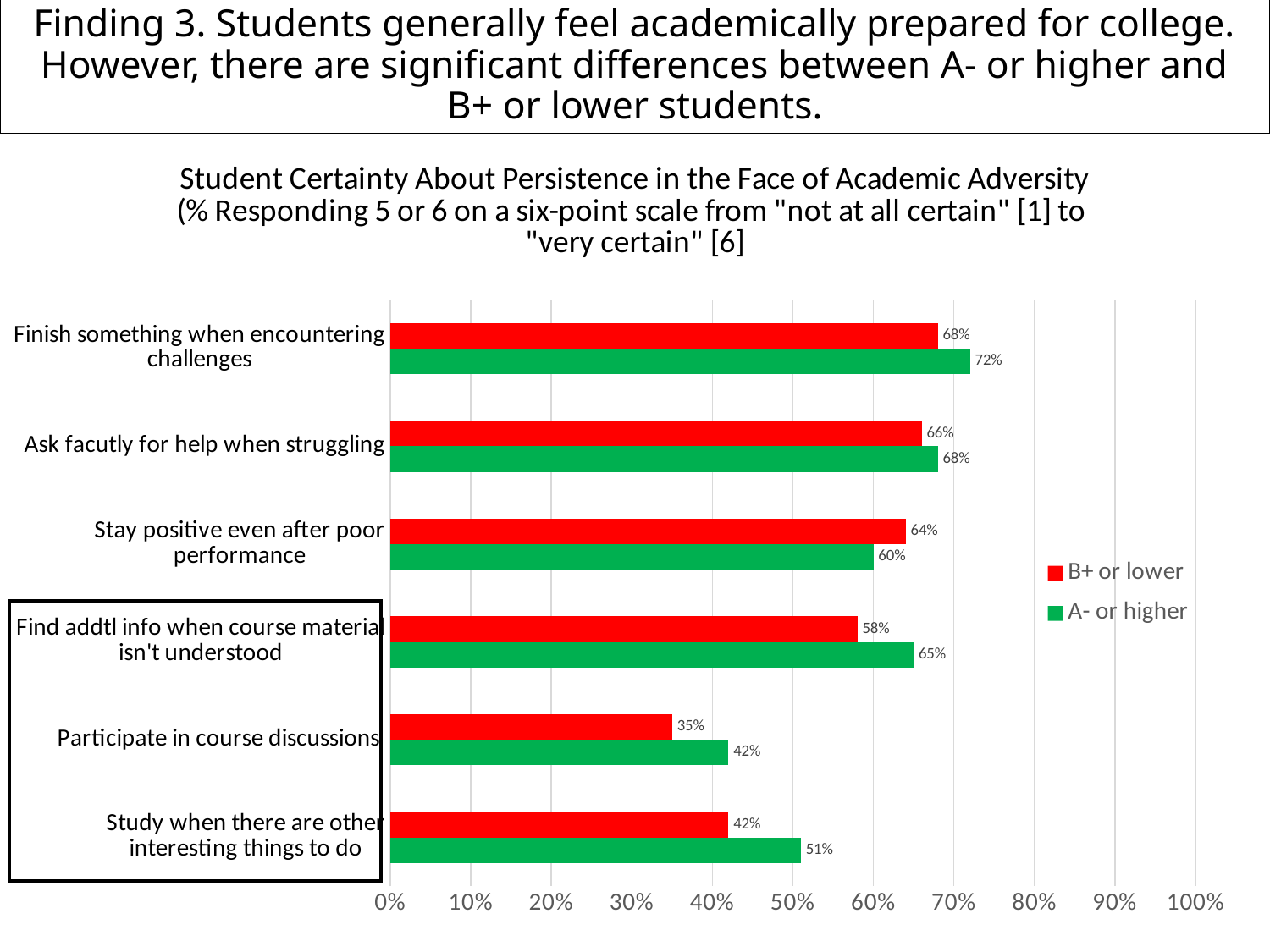
How many series does the legend list? 2 For 'Stay positive even after poor performance', which group has the higher value: B+ or lower or A- or higher? B+ or lower Which category has the lowest value for B+ or lower students? Participate in course discussions What is the difference between A- or higher and B+ or lower students for 'Find addtl info when course material isn't understood'? 7% Which colour represents A- or higher students in the chart? Green What percentage of B+ or lower students are certain they would finish something when encountering challenges? 68% How many categories are shown on the chart? 6 What is the difference between A- or higher and B+ or lower students for 'Study when there are other interesting things to do'? 9% What percentage of A- or higher students are certain they would participate in course discussions? 42% What kind of chart is shown on the slide? Bar chart What is the value for A- or higher students for 'Study when there are other interesting things to do'? 51% Which category has the highest value for A- or higher students? Finish something when encountering challenges